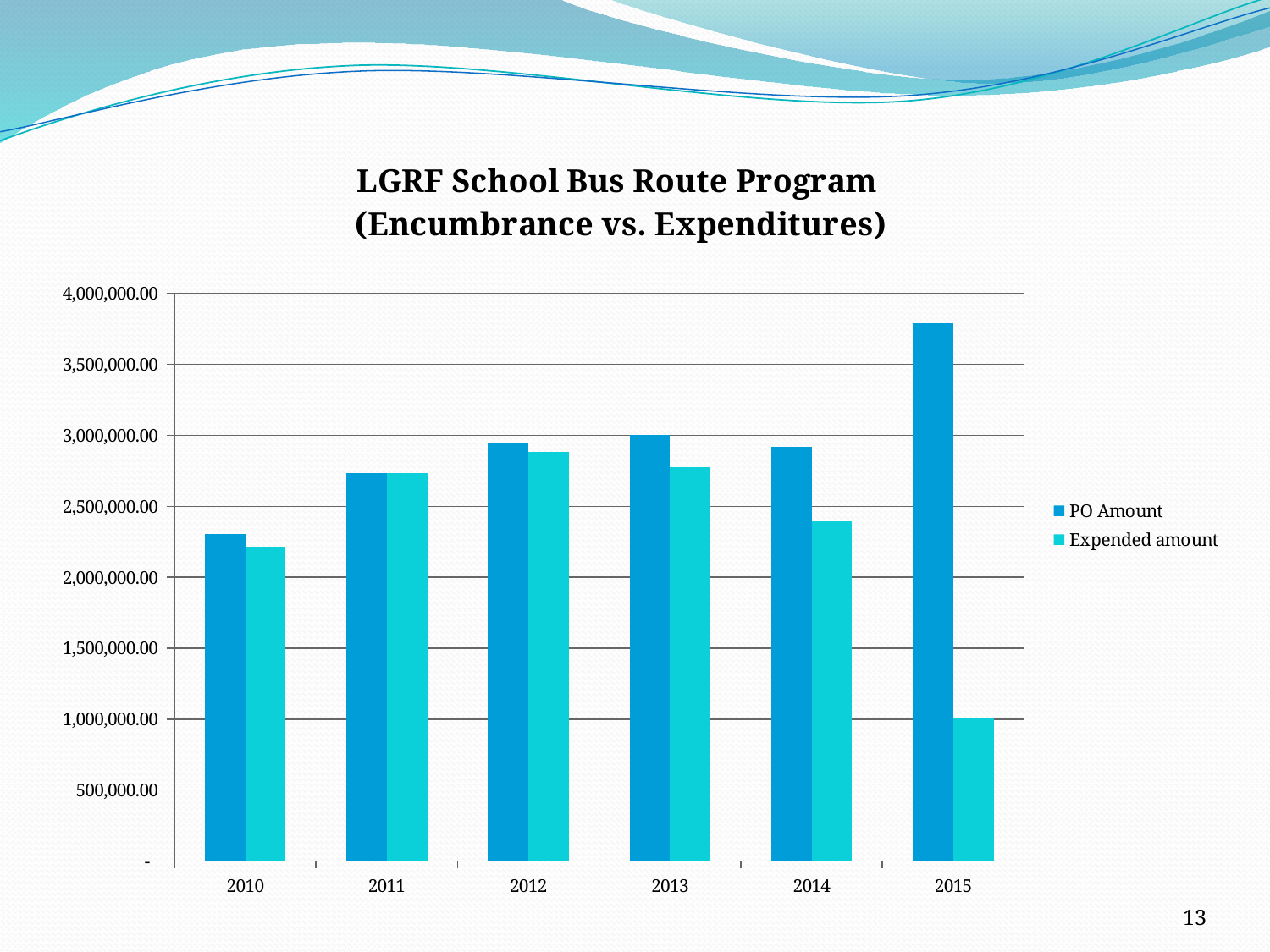
Which year has the highest PO Amount? 2015 How many series does the legend list? 2 In 2014, which is larger, the PO Amount or the Expended amount? PO Amount How many years are shown on the x axis? 6 Is the PO Amount for 2015 greater or less than 3,500,000.00? greater What is the title of the chart? LGRF School Bus Route Program (Encumbrance vs. Expenditures) Which year has the lowest Expended amount? 2015 Which year has the lowest PO Amount? 2010 Does the Expended amount rise or fall from 2013 to 2015? fall Is the Expended amount for 2015 greater or less than 1,500,000.00? less Is the PO Amount for 2010 greater or less than 2,500,000.00? less What kind of chart is shown on the slide? bar chart